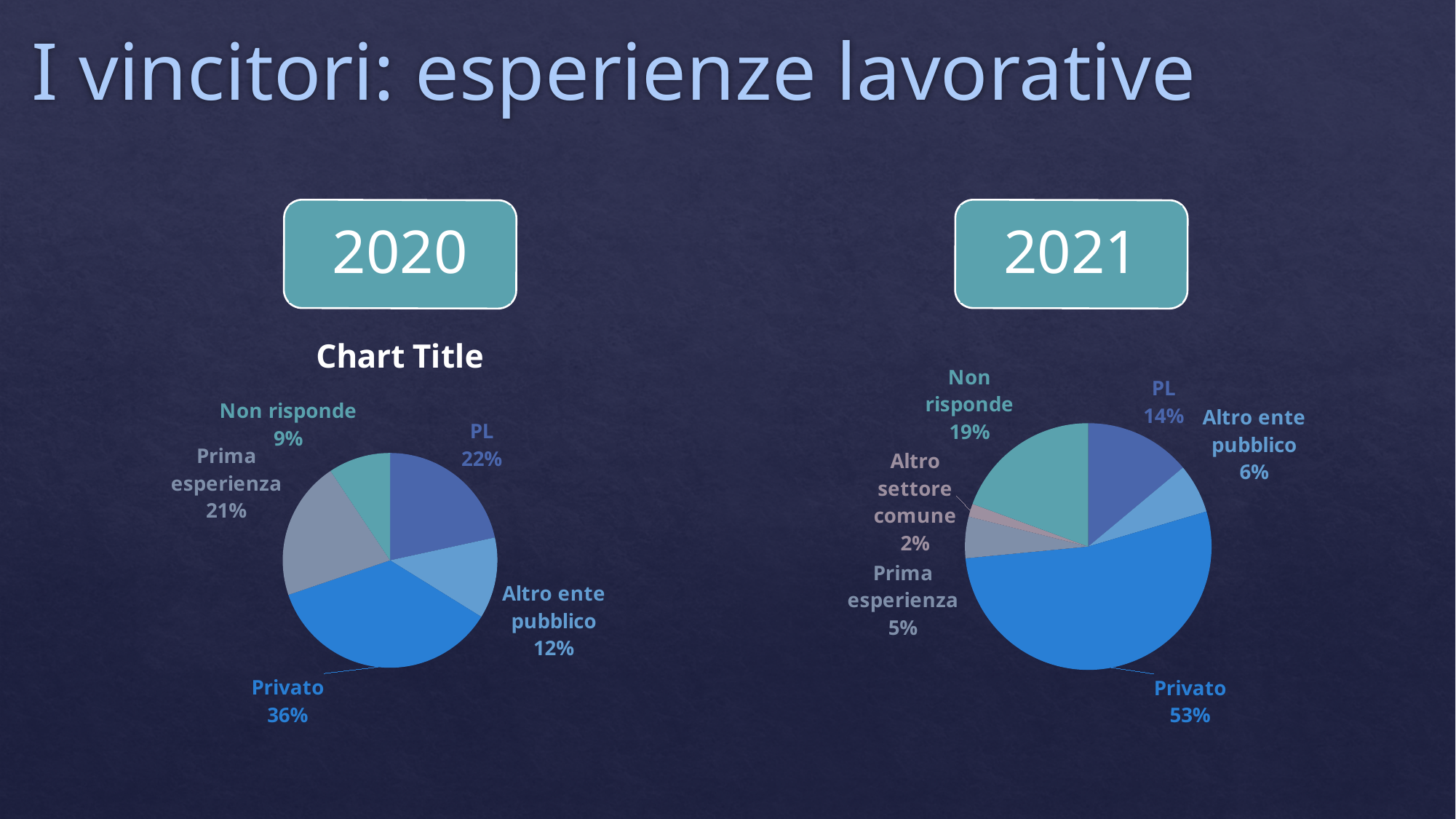
In the 2020 pie chart, what share does Altro ente pubblico have? 12% What type of chart is used for the 2020 data? Pie chart In the 2021 pie chart, what is the difference between Privato and PL? 39% In the 2021 pie chart, what share does Non risponde have? 19% How many slices does the 2020 pie chart have? 5 In the 2021 pie chart, which category has the smallest slice? Altro settore comune In the 2020 pie chart, which is larger, PL or Prima esperienza? PL In the 2020 pie chart, what share does Privato have? 36% In the 2020 pie chart, which category has the smallest slice? Non risponde What is the title shown above the 2020 pie chart? Chart Title In the 2020 pie chart, which category has the largest slice? Privato How many slices does the 2021 pie chart have? 6